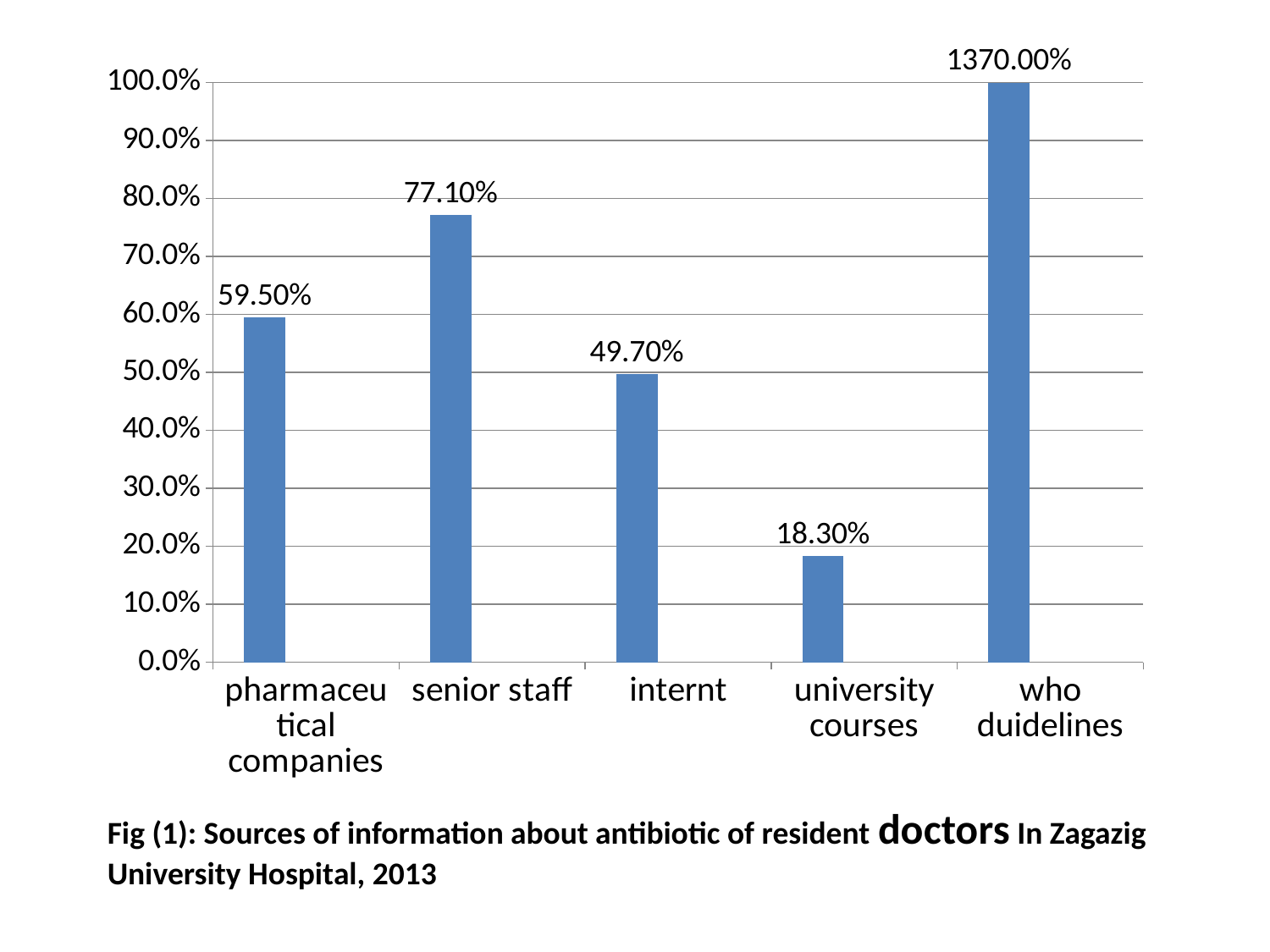
Which is larger, the value for pharmaceutical companies or the value for internt? pharmaceutical companies Is the value for internt greater or less than 40.0%? greater What is the difference between the values for senior staff and pharmaceutical companies? 17.60% How many categories are shown on the x axis? 5 Which category has the highest value? who duidelines Which category has the lowest value? university courses What is the value for pharmaceutical companies? 59.50% What is the value for senior staff? 77.10% What is the difference between the values for internt and university courses? 31.40% What kind of chart is shown on the slide? bar chart What is the data label shown for who duidelines? 1370.00% What is the value for university courses? 18.30%